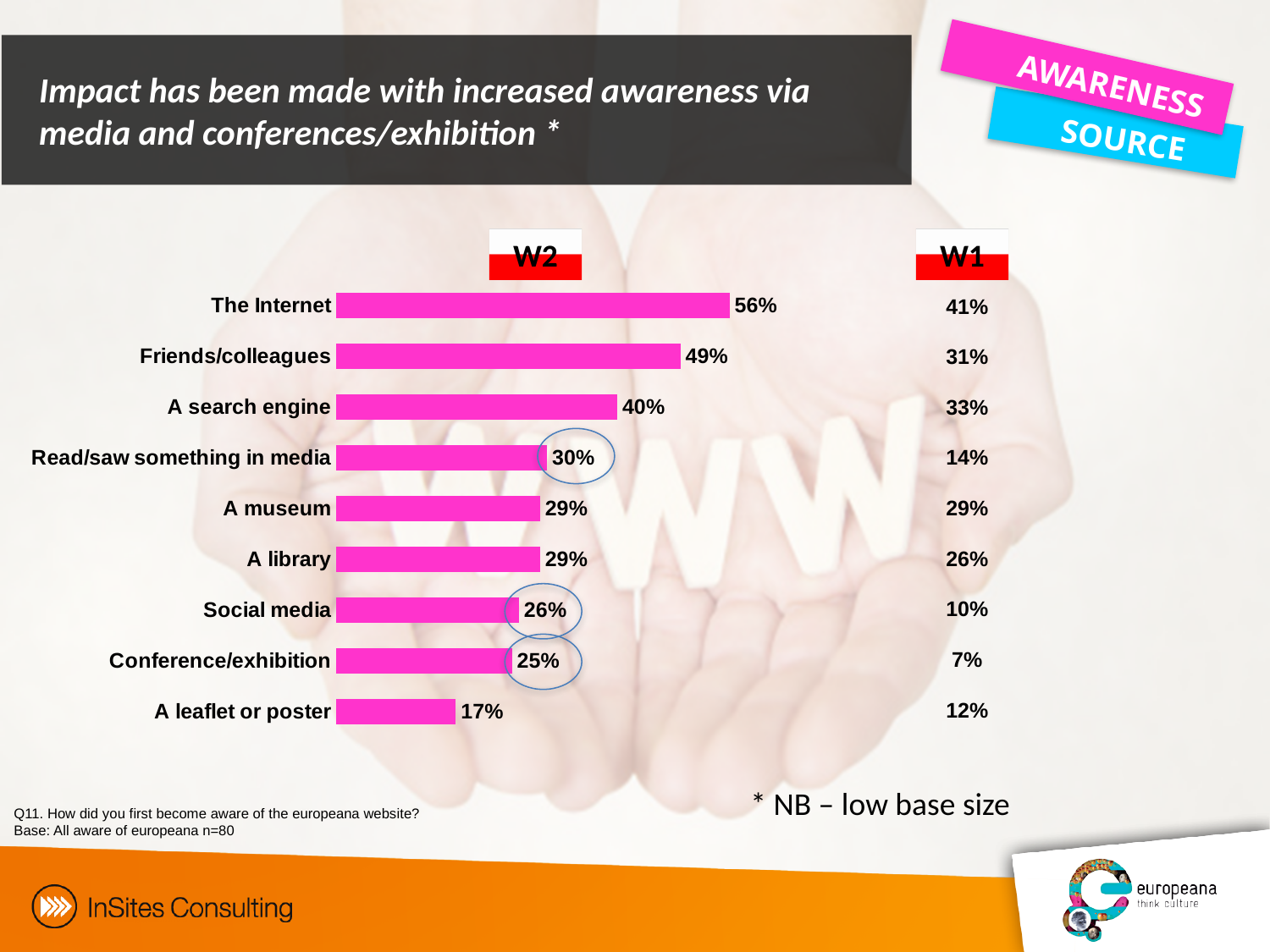
How many categories are shown in the chart? 9 What is the W2 value for Conference/exhibition? 25% Which category has the lowest W1 value? Conference/exhibition Which category has the highest W2 value? The Internet Which is larger, the W2 value for A search engine or the W2 value for A museum? A search engine What is the W2 value for The Internet? 56% What colour are the W2 bars in the chart? Pink What is the difference between the W2 and W1 values for Social media? 16% What is the difference between the W2 values for The Internet and Friends/colleagues? 7% Which category has the lowest W2 value? A leaflet or poster What is the W1 value for Read/saw something in media? 14% What kind of chart is shown on the slide? Bar chart